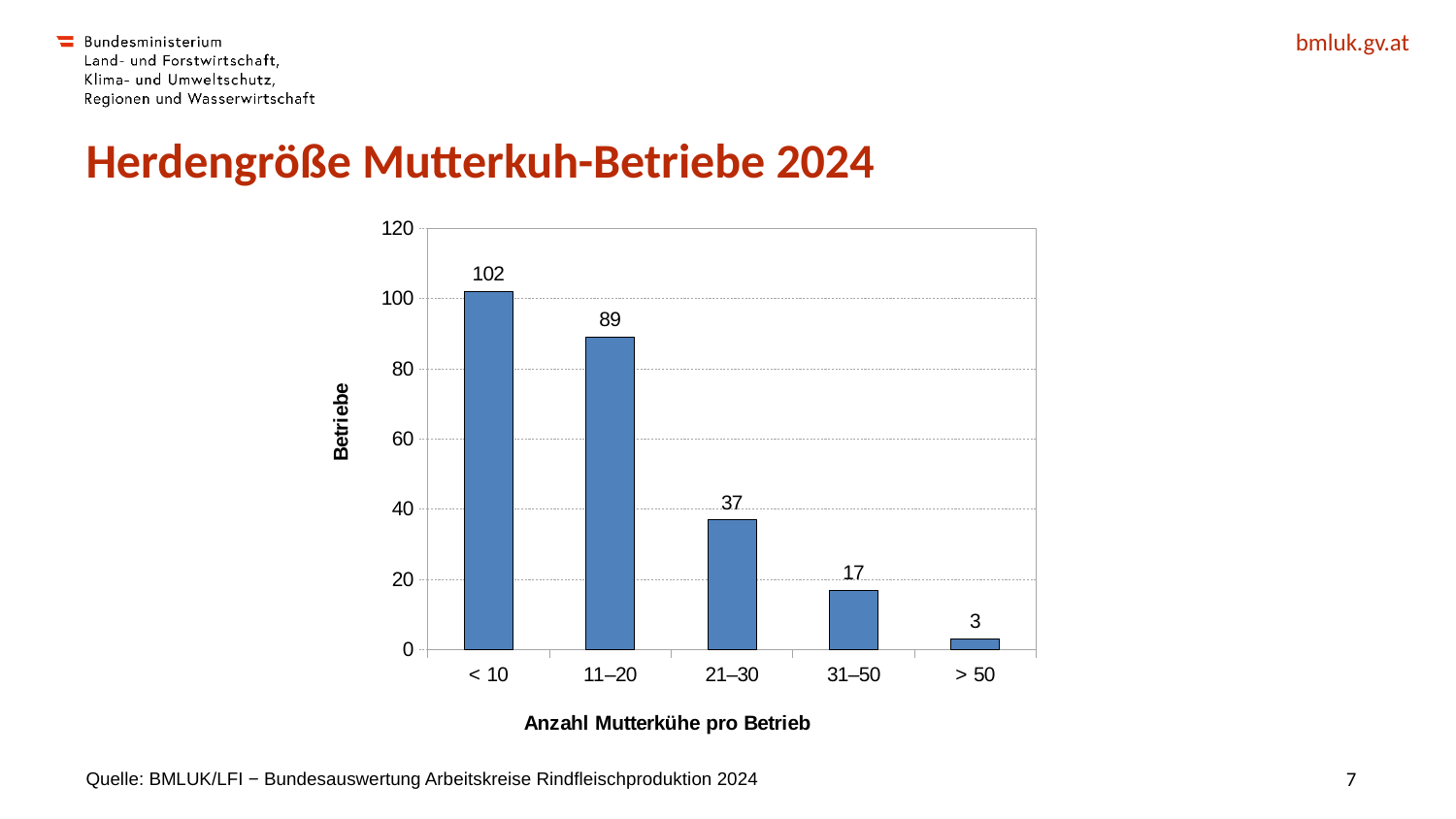
What is the value for the '11–20' category? 89 Which category has the lowest number of Betriebe? > 50 Which category has the highest number of Betriebe? < 10 What is the difference between the '21–30' and '31–50' categories? 20 What is the value for the '21–30' category? 37 What is the value for the '> 50' category? 3 Do the values rise or fall from left to right along the x axis? fall What is the difference between the '< 10' and '11–20' categories? 13 How many Betriebe are in the '< 10' category? 102 Which is larger, the value for '31–50' or the value for '> 50'? 31–50 How many categories are shown on the x axis? 5 What kind of chart is shown on the slide? bar chart